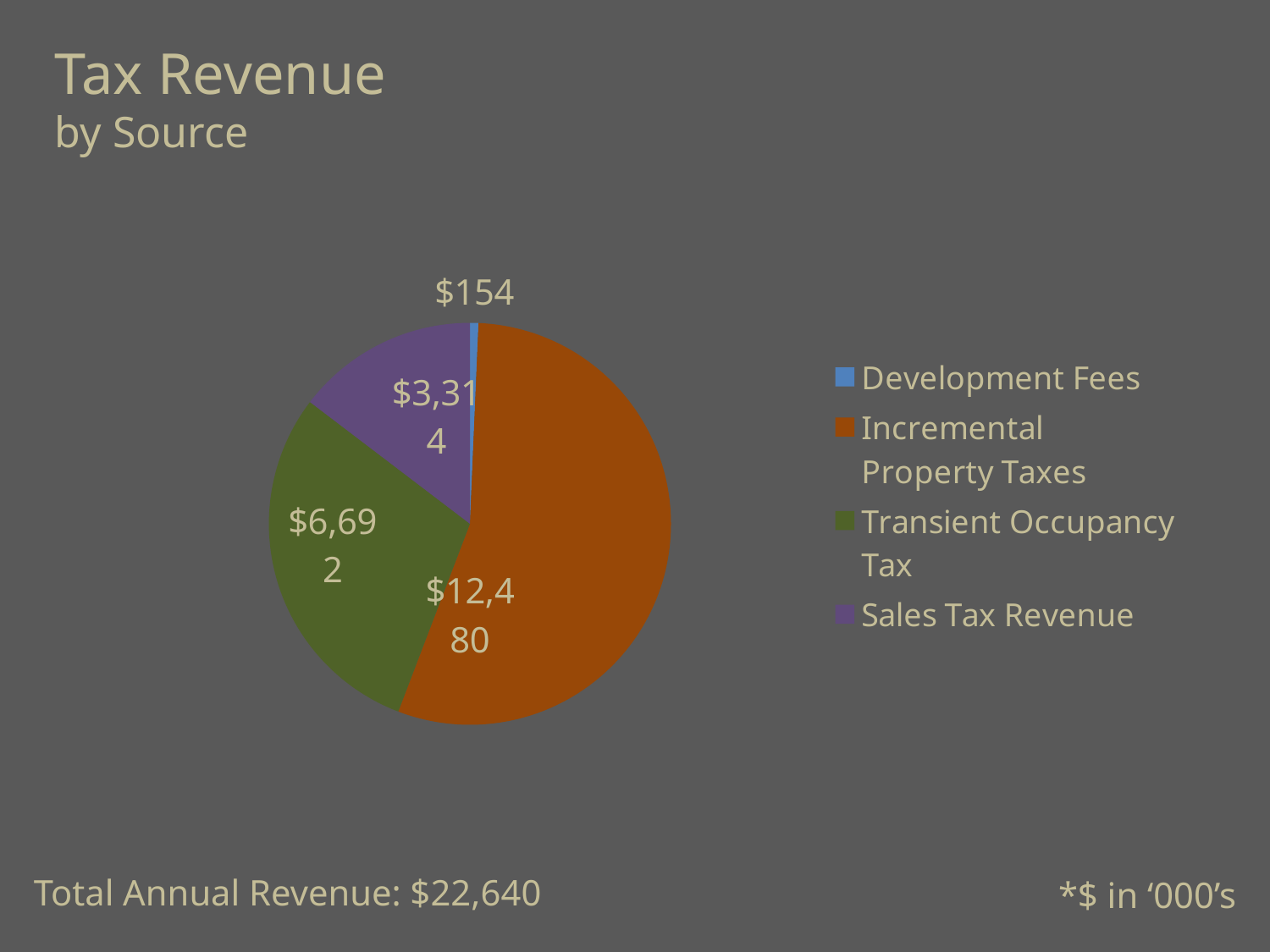
What is the value for Incremental Property Taxes? $12,480 Which source has the smallest share of tax revenue? Development Fees What is the difference between Sales Tax Revenue and Development Fees? $3,160 How many sources are shown in the pie chart? 4 What is the value for Sales Tax Revenue? $3,314 What is the value for Transient Occupancy Tax? $6,692 What kind of chart is shown on the slide? Pie chart What is the difference between Incremental Property Taxes and Transient Occupancy Tax? $5,788 What is the value for Development Fees? $154 Which is larger, Transient Occupancy Tax or Sales Tax Revenue? Transient Occupancy Tax What is the total annual revenue shown on the slide? $22,640 Which source has the largest share of tax revenue? Incremental Property Taxes